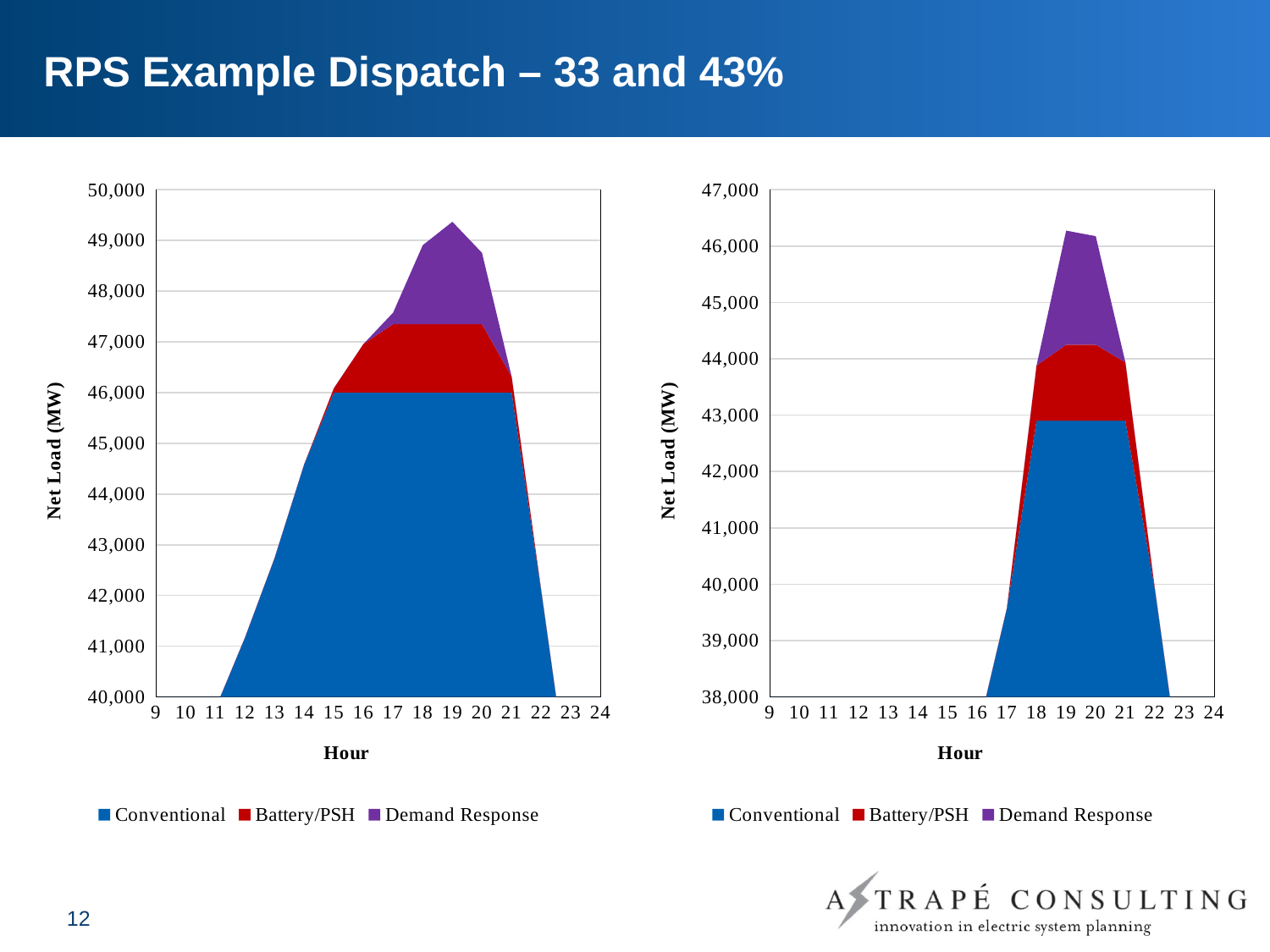
In the right chart, is the total net load at hour 19 greater or less than 46,000? greater What is the y-axis title of the right chart? Net Load (MW) In the left chart, does the Conventional series rise or fall from hour 11 to hour 15? rise In the left chart, is the total net load at hour 19 greater or less than 49,000? greater What are the three series named in the legend of the left chart? Conventional, Battery/PSH, Demand Response How many series does the legend of the right chart list? 3 How many hour labels are shown along the x axis of the left chart? 16 In the left chart, at which hour does the total net load reach its highest point? 19 In the left chart, is the Conventional value at hour 16 greater or less than 45,000? greater What kind of chart is the left chart on the slide? Stacked area chart